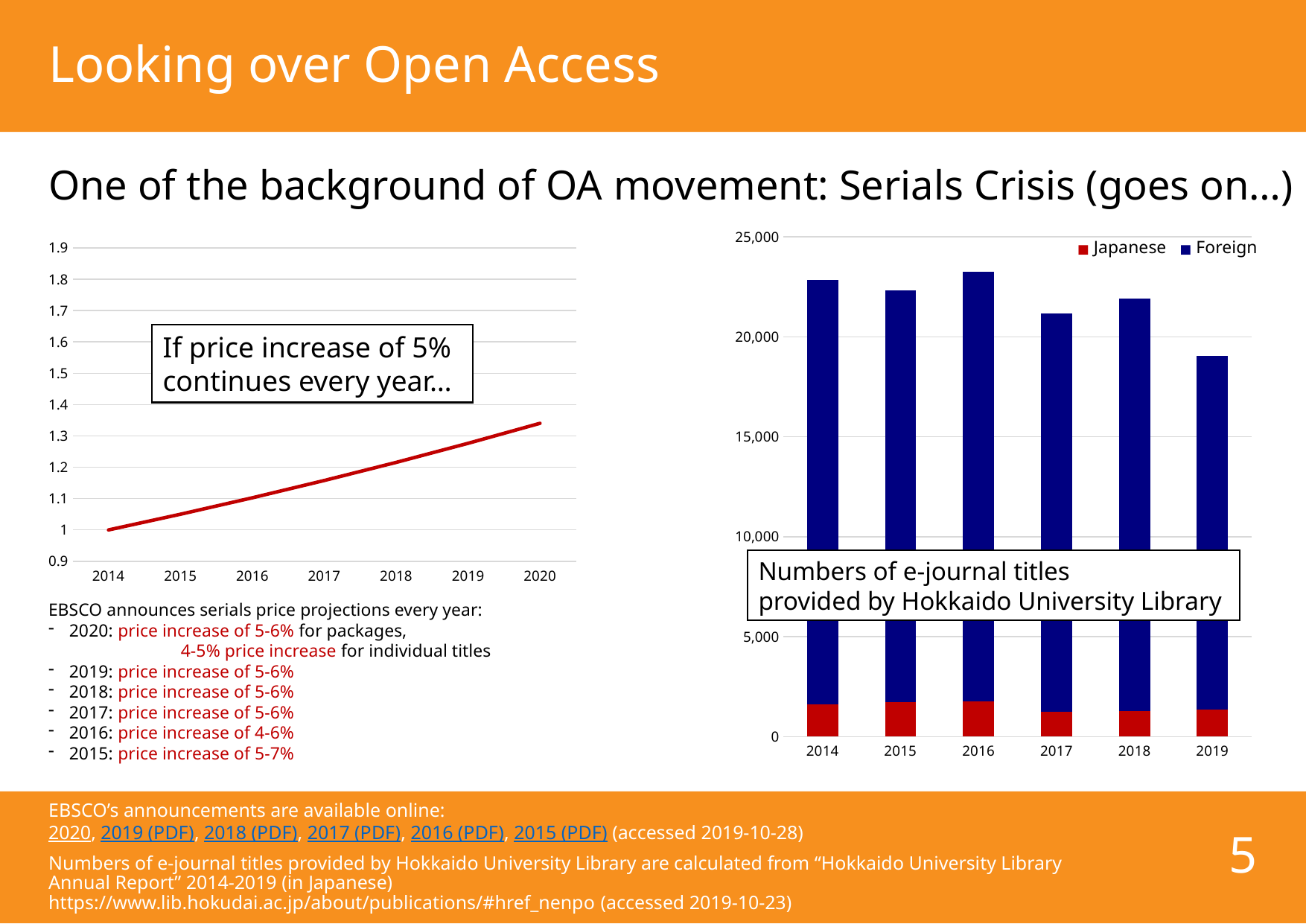
How many series does the legend of the right chart (e-journal titles) list? 2 In the left line chart, what is the value for 2014? 1 In the right chart (e-journal titles), is the total for 2019 greater or less than 20,000? less In the left line chart, do the values rise or fall from 2014 to 2020? rise In the left line chart, is the value for 2020 greater or less than 1.3? greater In the right chart (e-journal titles), which colour represents the Japanese series? red What kind of chart is the left chart (the one with the 'If price increase of 5% continues every year...' annotation)? line chart How many years are shown on the x axis of the right chart (e-journal titles)? 6 What kind of chart is the right chart showing numbers of e-journal titles provided by Hokkaido University Library? stacked bar chart In the left line chart, is the value for 2017 greater or less than 1.1? greater In the right chart (e-journal titles), which year has the lowest total number of titles? 2019 How many years are plotted on the x axis of the left line chart? 7